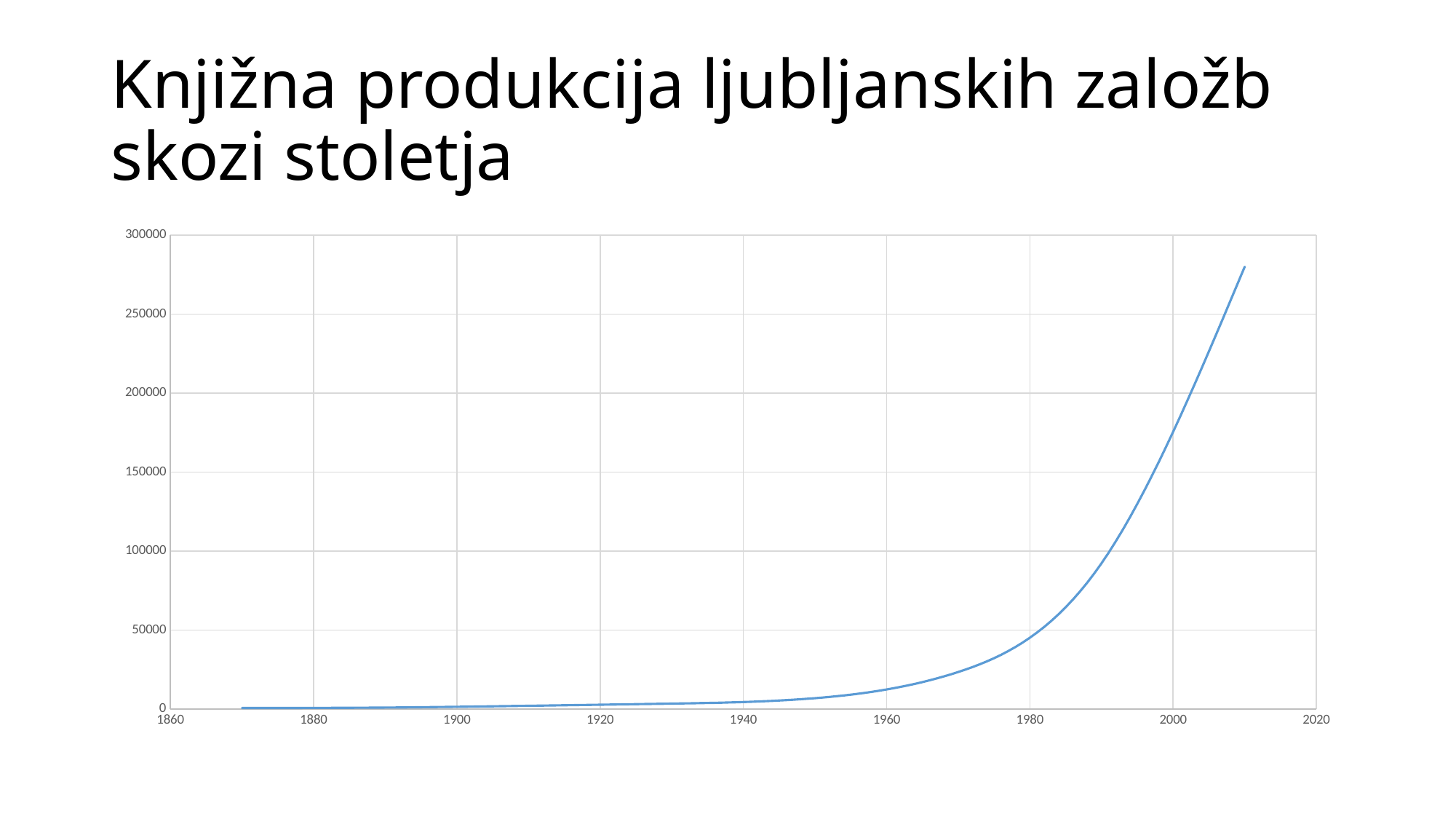
Around which year on the x axis does the line reach its highest value? 2010 Is the value for the year 2000 greater or less than 150000? greater Do the values rise or fall as the years increase along the x axis? rise What is the title of the slide? Knjižna produkcija ljubljanskih založb skozi stoletja Is the value for the year 2010 greater or less than 250000? greater What kind of chart is shown on the slide? line chart Is the value for the year 1920 greater or less than 50000? less Which is larger, the value for 2000 or the value for 1980? 2000 What is the highest value shown on the y axis? 300000